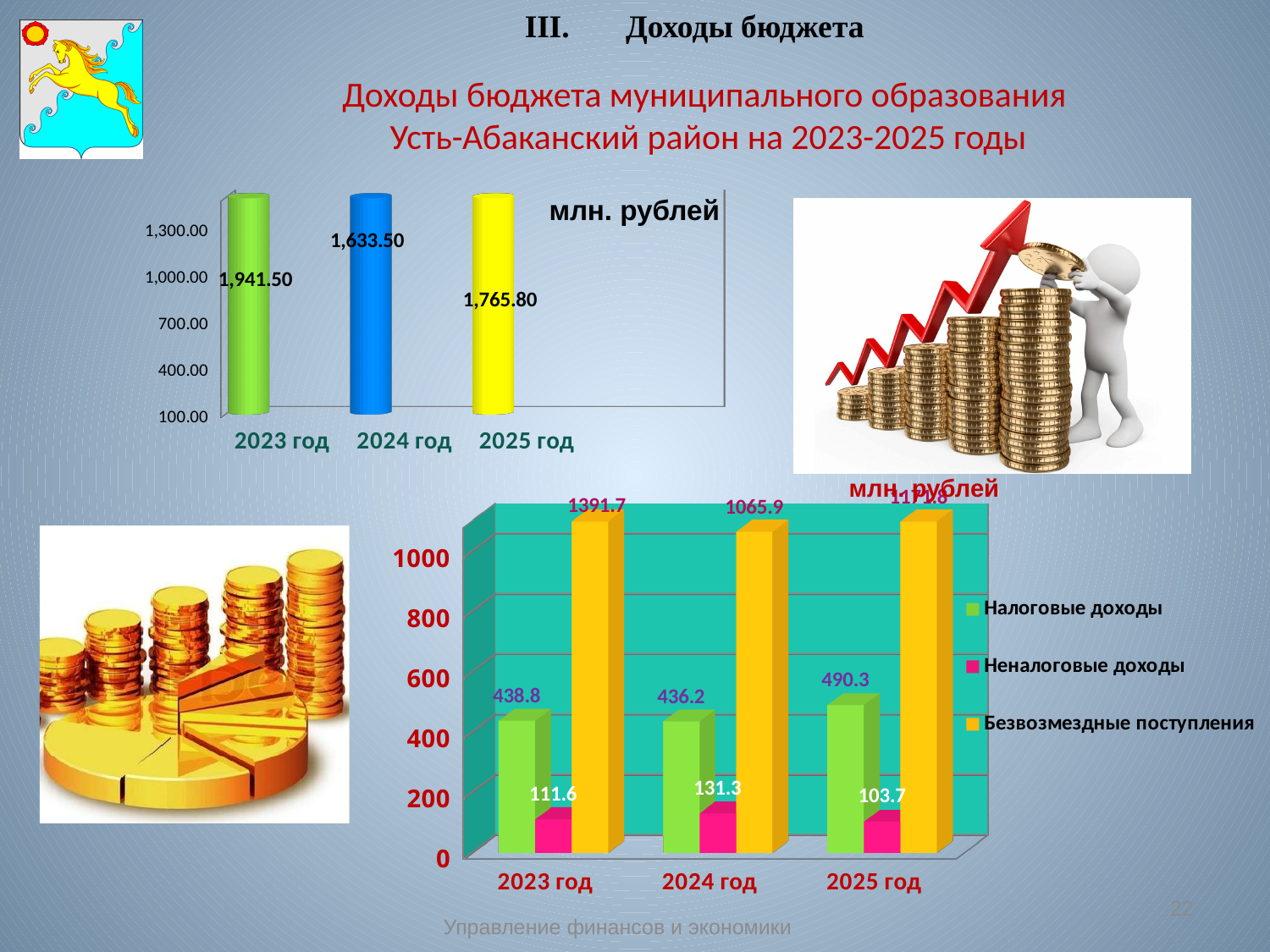
In the bottom chart, by how much does Налоговые доходы in 2025 год exceed Налоговые доходы in 2023 год? 51.5 In the top chart, what is the difference between the values for 2023 год and 2024 год? 308.00 How many bars are shown in the top chart? 3 In the bottom chart, what is the value of Неналоговые доходы for 2024 год? 131.3 In the bottom chart, which year has the highest value for Неналоговые доходы? 2024 год In the bottom chart, what is the value of Налоговые доходы for 2025 год? 490.3 How many series does the legend of the bottom chart list? 3 In the bottom chart, what is the value of Безвозмездные поступления for 2023 год? 1391.7 In the top chart, what is the value for 2025 год? 1,765.80 In the top chart, what is the value for 2023 год? 1,941.50 In the top chart, which year has the lowest value according to the data labels? 2024 год What type of chart is the top chart? bar chart